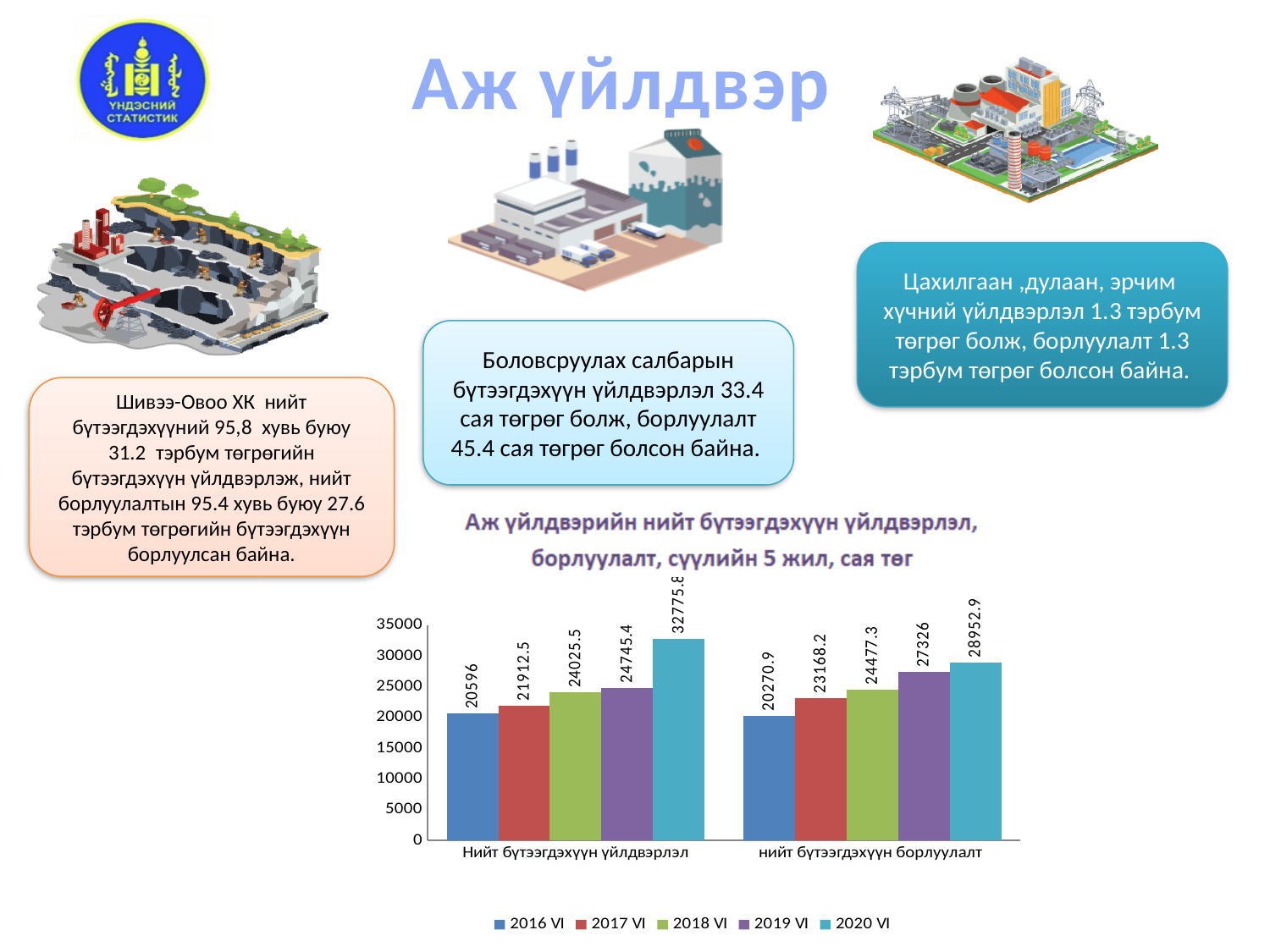
Which series has the lowest value in the category 'Нийт бүтээгдэхүүн үйлдвэрлэл'? 2016 VI What is the value for 2016 VI in the category 'Нийт бүтээгдэхүүн үйлдвэрлэл'? 20596 What is the value for 2019 VI in the category 'нийт бүтээгдэхүүн борлуулалт'? 27326 Which is larger: the 2017 VI value for 'Нийт бүтээгдэхүүн үйлдвэрлэл' or the 2017 VI value for 'нийт бүтээгдэхүүн борлуулалт'? нийт бүтээгдэхүүн борлуулалт What is the difference between the 2019 VI and 2017 VI values in the category 'нийт бүтээгдэхүүн борлуулалт'? 4157.8 How many series does the chart legend list? 5 What is the value for 2020 VI in the category 'нийт бүтээгдэхүүн борлуулалт'? 28952.9 Which series has the highest value in the category 'нийт бүтээгдэхүүн борлуулалт'? 2020 VI What kind of chart is shown on the slide? bar chart Is the value for 2020 VI in the category 'Нийт бүтээгдэхүүн үйлдвэрлэл' greater or less than 30000? greater What is the value for 2018 VI in the category 'Нийт бүтээгдэхүүн үйлдвэрлэл'? 24025.5 How many categories are shown on the x axis of the chart? 2